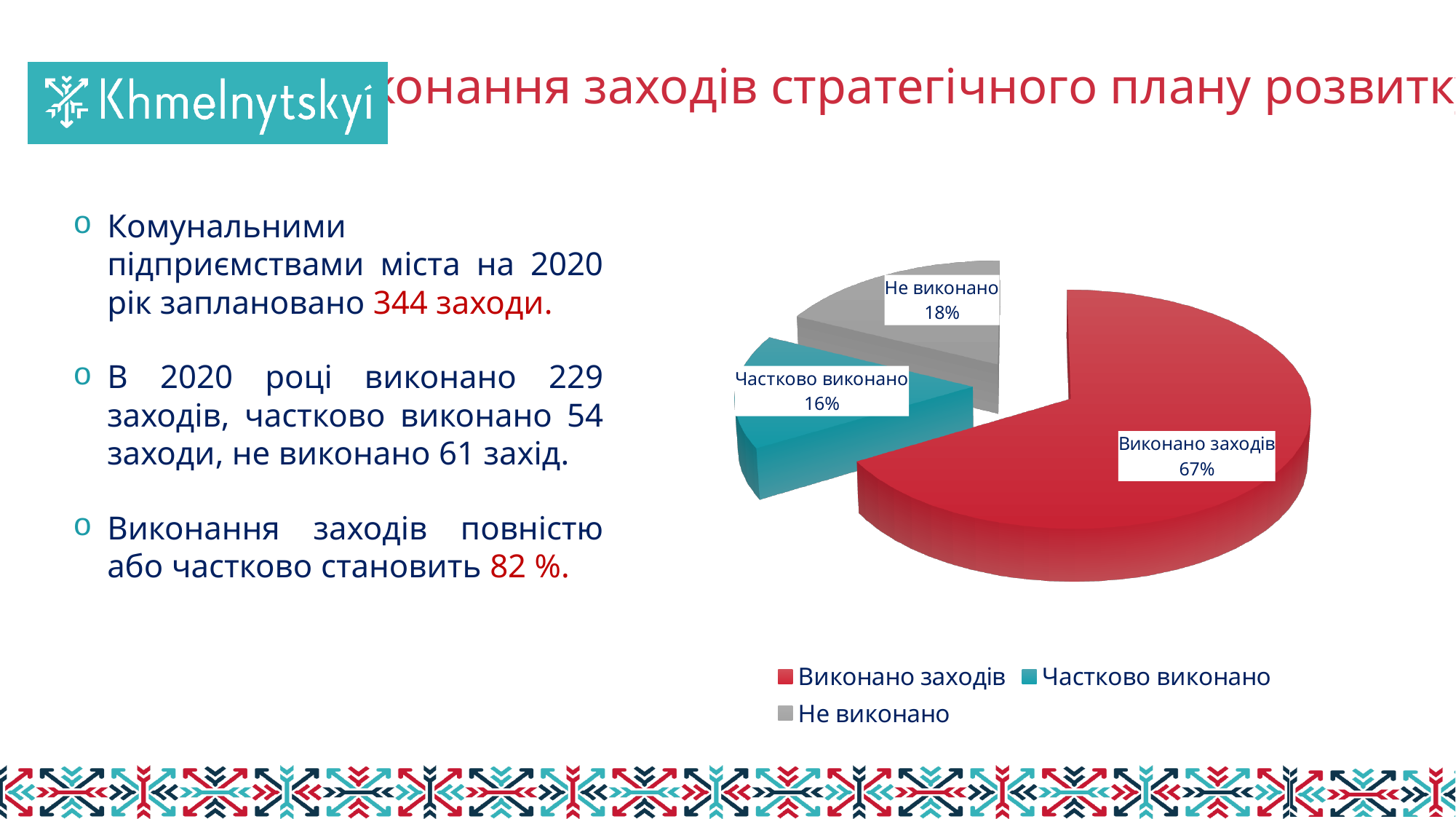
What share of the pie does "Не виконано" represent? 18% What share of the pie does "Частково виконано" represent? 16% What kind of chart is shown on the slide? pie chart Which slice of the pie chart is the smallest? Частково виконано How many entries does the legend of the pie chart list? 3 What is the difference in percentage points between "Виконано заходів" and "Не виконано"? 49 What share of the pie does "Виконано заходів" represent? 67% What colour is the "Виконано заходів" slice in the pie chart? red How many slices does the pie chart have? 3 What colour is the "Не виконано" slice in the pie chart? grey Which slice of the pie chart is the largest? Виконано заходів Which is larger in the pie chart: "Не виконано" or "Частково виконано"? Не виконано